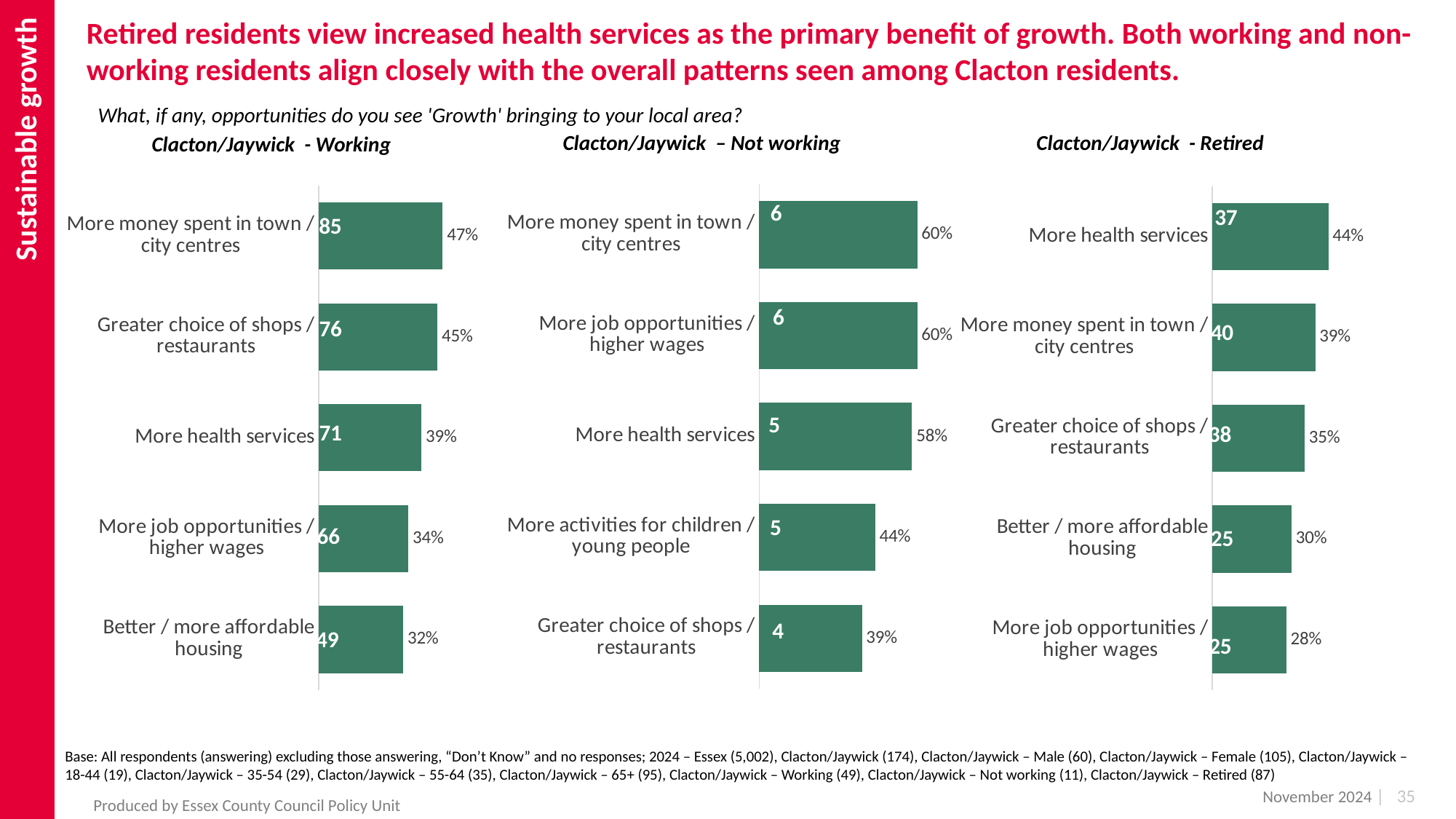
What survey question is shown above the three charts? What, if any, opportunities do you see 'Growth' bringing to your local area? In the Clacton/Jaywick - Working chart, what is the difference in percentage points between 'More money spent in town / city centres' and 'Better / more affordable housing'? 15 In the Clacton/Jaywick – Not working chart, what percentage is shown for 'More activities for children / young people'? 44% In the Clacton/Jaywick - Retired chart, which category has the highest percentage? More health services In the Clacton/Jaywick - Retired chart, which has the larger percentage: 'More money spent in town / city centres' or 'Greater choice of shops / restaurants'? More money spent in town / city centres How many categories are shown in the Clacton/Jaywick – Not working chart? 5 In the Clacton/Jaywick - Retired chart, what is the difference in percentage points between 'Better / more affordable housing' and 'More job opportunities / higher wages'? 2 In the Clacton/Jaywick - Working chart, which category has the lowest percentage? Better / more affordable housing In the Clacton/Jaywick - Working chart, what percentage is shown for 'More money spent in town / city centres'? 47% What type of chart is used for the Clacton/Jaywick - Working data? Bar chart In the Clacton/Jaywick – Not working chart, what percentage is shown for 'Greater choice of shops / restaurants'? 39% In the Clacton/Jaywick - Retired chart, what percentage is shown for 'More health services'? 44%